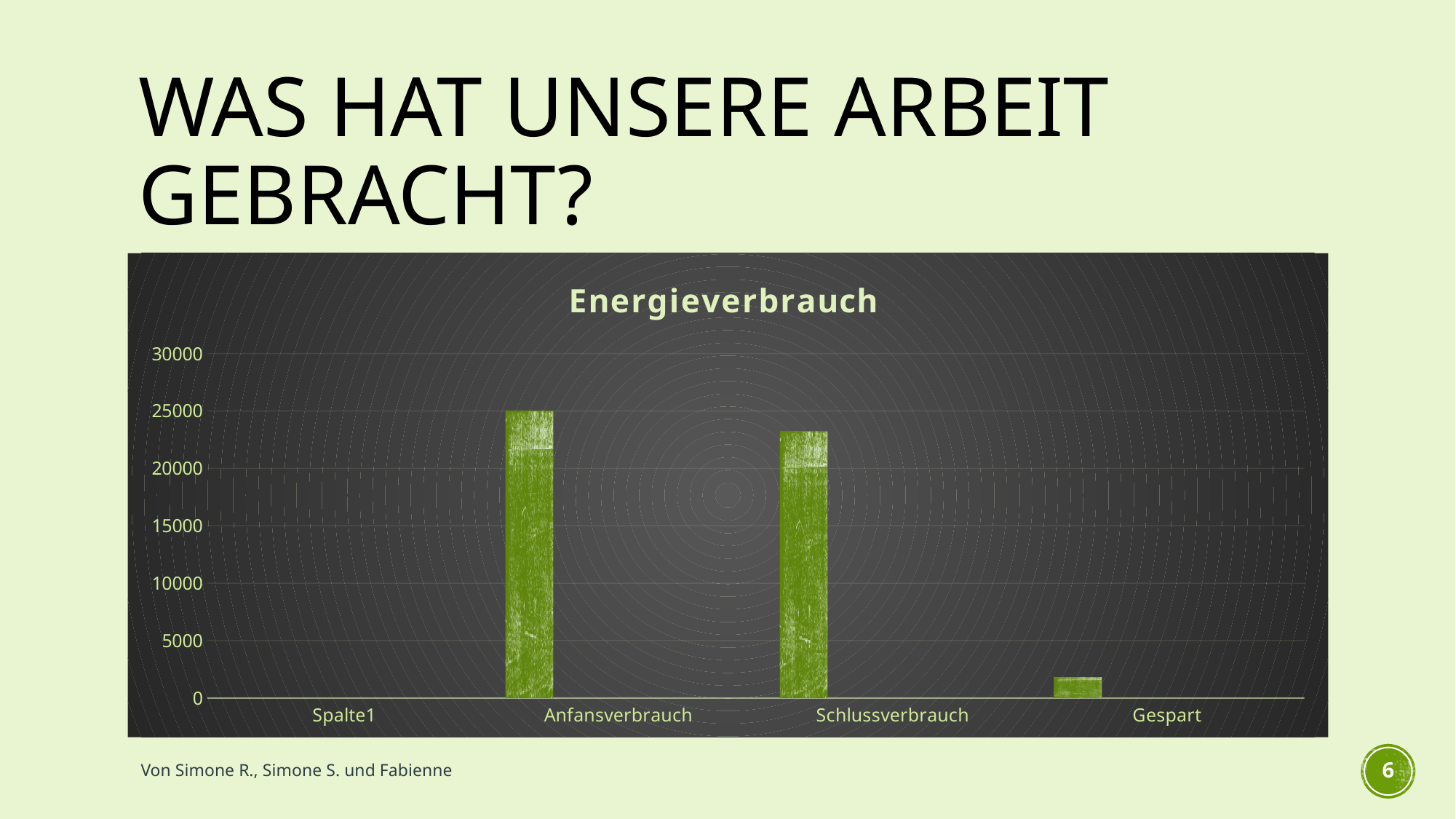
What is the highest value shown on the y axis of the chart? 30000 Is the value for Schlussverbrauch greater or less than 25000? less What kind of chart is shown on the slide? bar chart Which is larger, the value for Schlussverbrauch or the value for Gespart? Schlussverbrauch Is the value for Anfansverbrauch greater or less than 20000? greater Is the value for Schlussverbrauch greater or less than 20000? greater What is the title of the chart? Energieverbrauch How many categories are labelled on the x axis of the chart? 4 Which is larger, the value for Anfansverbrauch or the value for Schlussverbrauch? Anfansverbrauch Which category has the highest bar in the chart? Anfansverbrauch Which category with a visible bar has the lowest value in the chart? Gespart